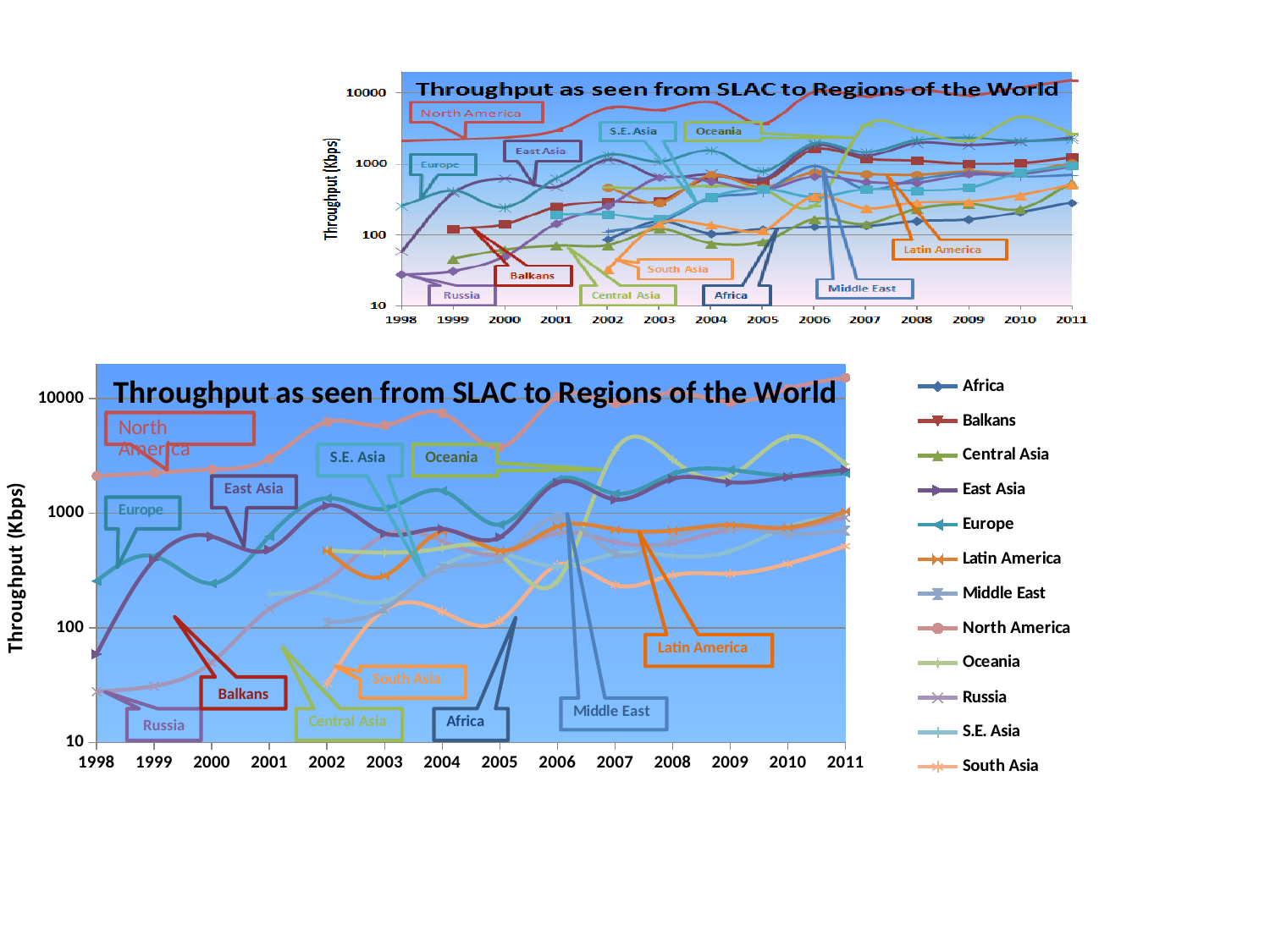
On the larger chart at the bottom of the slide, what is the label on the y axis? Throughput (Kbps) On the larger chart at the bottom of the slide, does the North America line rise or fall from 1998 to 2011? rise On the larger chart at the bottom of the slide, what kind of chart is shown? line chart On the larger chart at the bottom of the slide, is the value for Russia in 1998 greater or less than 100? less On the larger chart at the bottom of the slide, which region has the highest throughput in 2011? North America On the larger chart at the bottom of the slide, is the value for Africa in 2011 greater or less than 1000? less On the larger chart at the bottom of the slide, how many series does the legend list? 12 On the larger chart at the bottom of the slide, is the value for North America in 2011 greater or less than 10000? greater What is the title of the larger chart at the bottom of the slide? Throughput as seen from SLAC to Regions of the World On the larger chart at the bottom of the slide, how many years are marked along the x axis? 14 On the larger chart at the bottom of the slide, which is larger in 2011: North America or Africa? North America